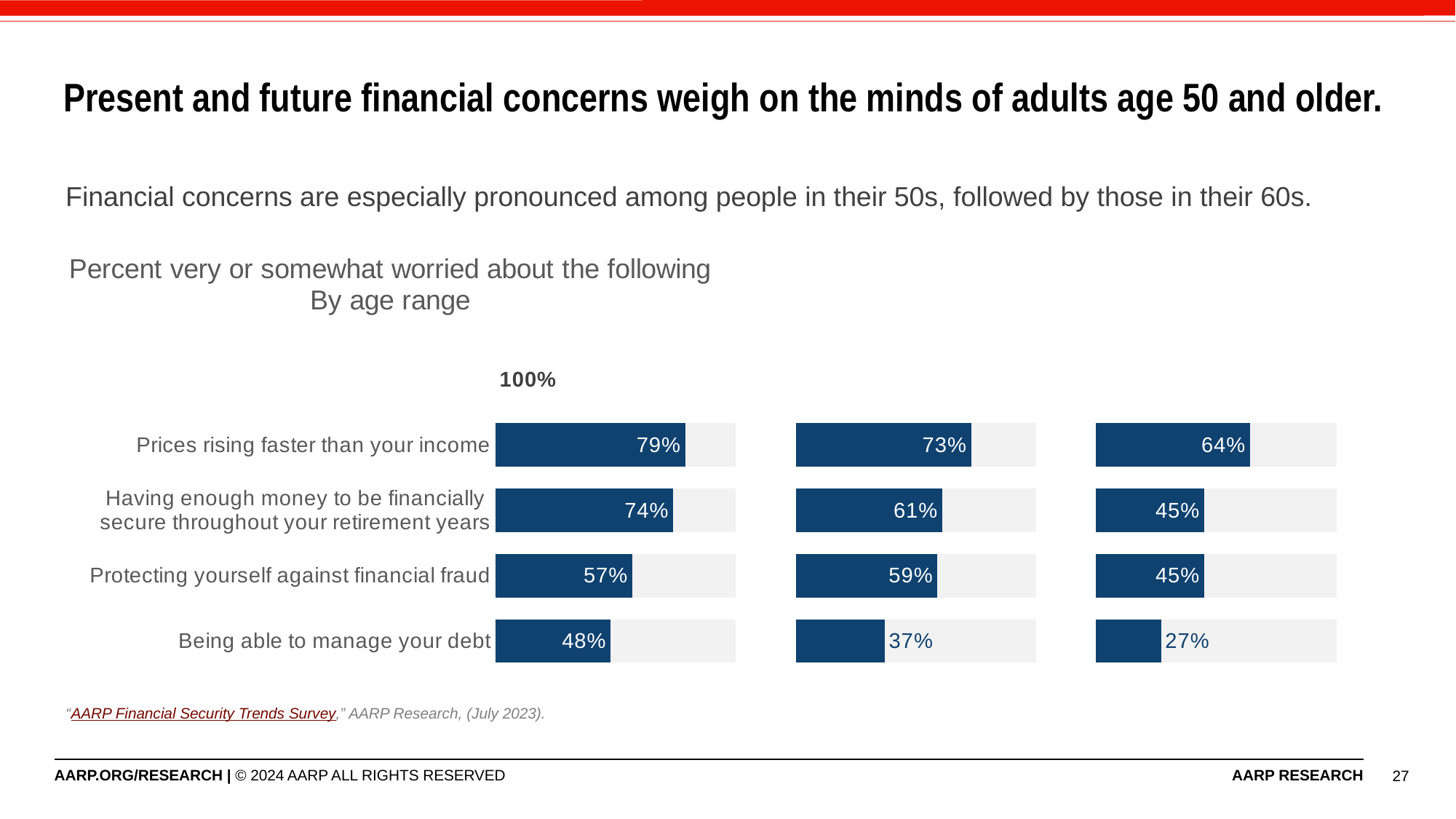
In the left chart, which category has the highest value? Prices rising faster than your income In the right chart, what is the value for 'Having enough money to be financially secure throughout your retirement years'? 45% For 'Protecting yourself against financial fraud', which chart shows the larger value, the left chart or the middle chart? Middle chart In the middle chart, what is the value for 'Protecting yourself against financial fraud'? 59% What is the difference between the left chart's and the right chart's values for 'Prices rising faster than your income'? 15 percentage points What kind of chart is used on this slide? Bar chart In the right chart, what is the value for 'Being able to manage your debt'? 27% What is the axis maximum label shown above the charts? 100% How many categories are shown in each chart? 4 In the middle chart, which category has the lowest value? Being able to manage your debt In the middle chart, what is the difference between 'Having enough money to be financially secure throughout your retirement years' and 'Being able to manage your debt'? 24 percentage points In the left chart, what is the value for 'Prices rising faster than your income'? 79%